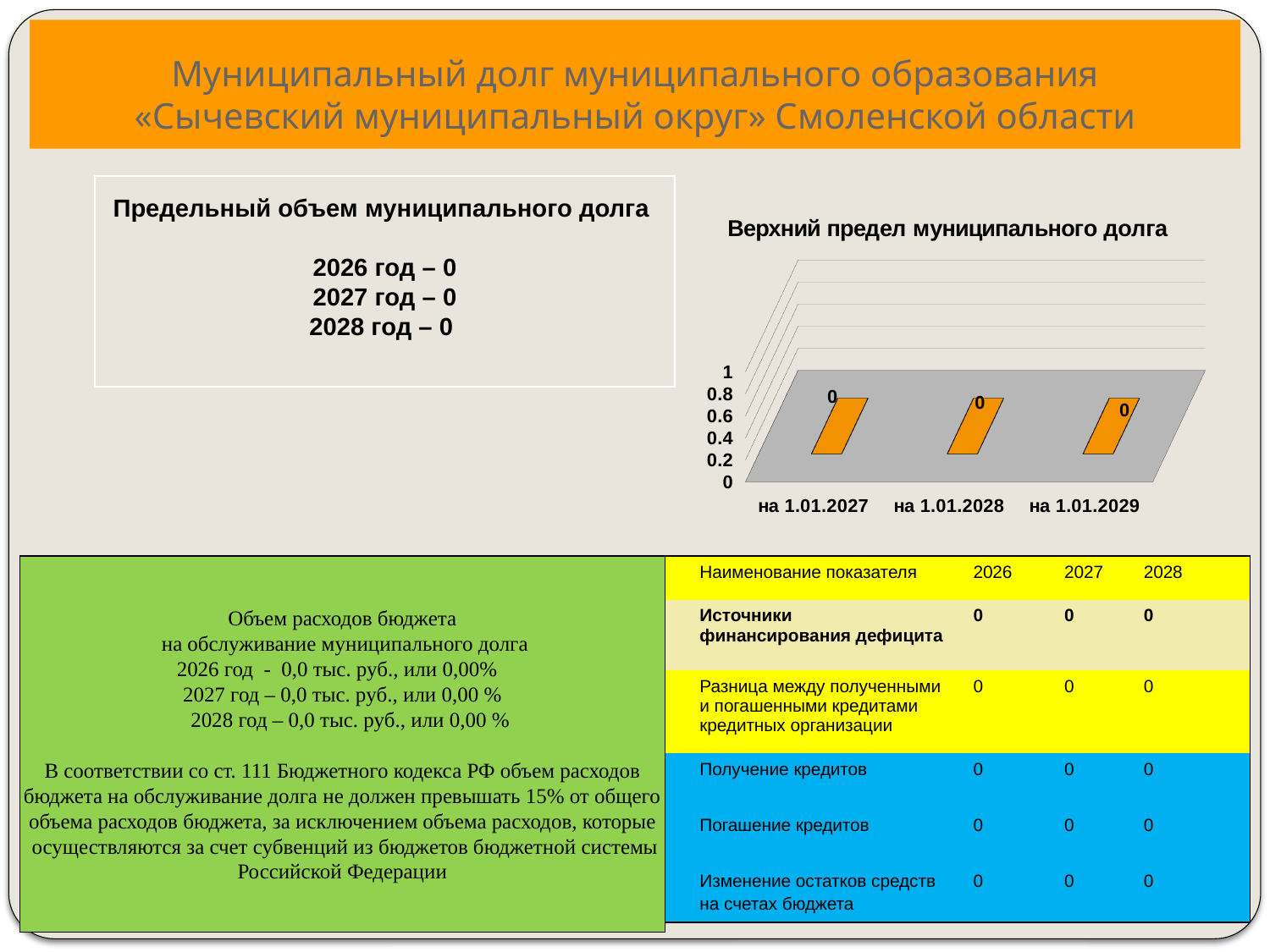
How many categories are shown on the x axis of the chart "Верхний предел муниципального долга"? 3 What is the value for на 1.01.2027 in the chart "Верхний предел муниципального долга"? 0 What is the highest tick value shown on the vertical axis of the chart "Верхний предел муниципального долга"? 1 What is the value for на 1.01.2029 in the chart "Верхний предел муниципального долга"? 0 Do the values in the chart "Верхний предел муниципального долга" rise, fall or stay the same from на 1.01.2027 to на 1.01.2029? stay the same What is the value for на 1.01.2028 in the chart "Верхний предел муниципального долга"? 0 What is the label of the first category on the x axis of the chart "Верхний предел муниципального долга"? на 1.01.2027 What is the title of the chart on the slide? Верхний предел муниципального долга What kind of chart is "Верхний предел муниципального долга"? bar chart What is the difference between the values for на 1.01.2027 and на 1.01.2029 in the chart "Верхний предел муниципального долга"? 0 Is the value for на 1.01.2028 in the chart "Верхний предел муниципального долга" greater or less than 0.2? less